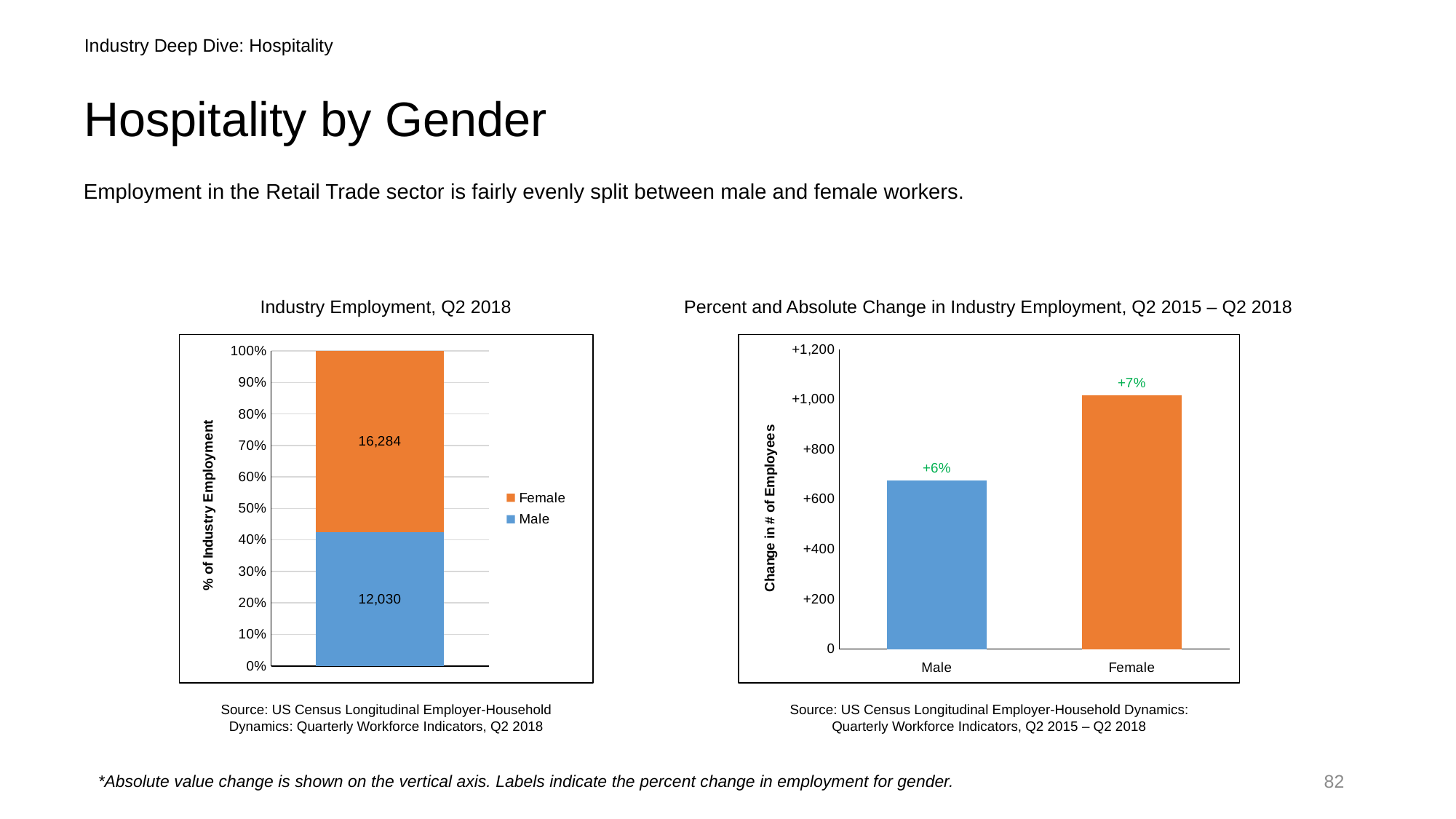
In the 'Percent and Absolute Change in Industry Employment, Q2 2015 – Q2 2018' chart, is the value for Male greater or less than +800? less In the 'Percent and Absolute Change in Industry Employment, Q2 2015 – Q2 2018' chart, which category has the highest bar? Female In the 'Percent and Absolute Change in Industry Employment, Q2 2015 – Q2 2018' chart, how many categories are shown on the x axis? 2 In the 'Percent and Absolute Change in Industry Employment, Q2 2015 – Q2 2018' chart, what percent change label is shown for Male? +6% In the 'Industry Employment, Q2 2018' chart, what is the difference between the Female and Male values? 4,254 In the 'Industry Employment, Q2 2018' chart, what is the total of the stacked bar? 28,314 In the 'Industry Employment, Q2 2018' chart, which colour represents Male? Blue In the 'Industry Employment, Q2 2018' chart, which group has the larger value, Female or Male? Female In the 'Industry Employment, Q2 2018' chart, what is the value shown for Female? 16,284 In the 'Percent and Absolute Change in Industry Employment, Q2 2015 – Q2 2018' chart, what percent change label is shown for Female? +7% In the 'Industry Employment, Q2 2018' chart, what is the value shown for Male? 12,030 In the 'Industry Employment, Q2 2018' chart, how many series does the legend list? 2